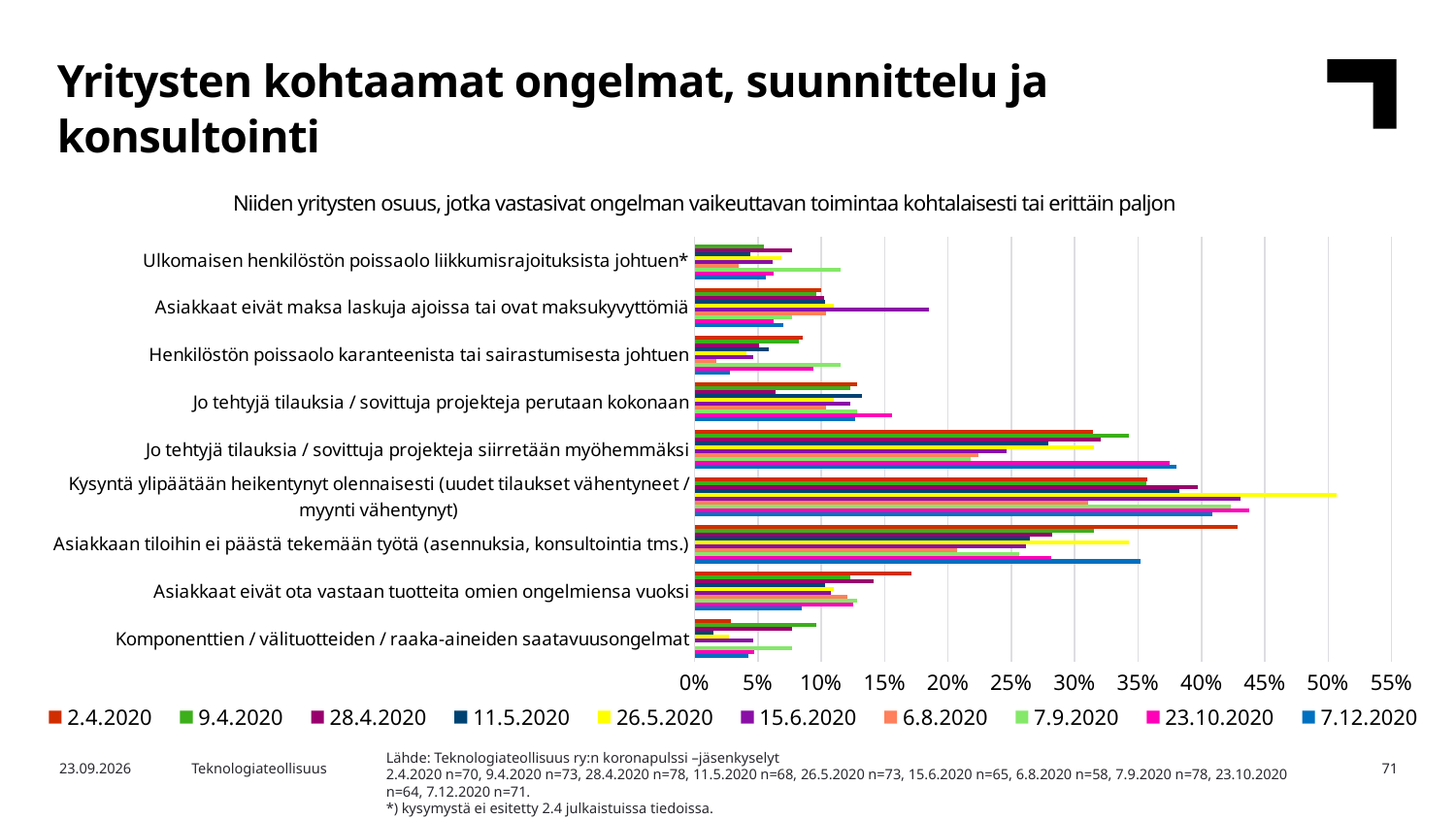
What is the highest value shown on the horizontal axis of the chart? 55% How many series (survey dates) does the legend list? 10 What kind of chart is shown on the slide? Bar chart How many problem categories are listed on the vertical axis of the chart? 9 Which category has the longest bars overall in the chart? Kysyntä ylipäätään heikentynyt olennaisesti (uudet tilaukset vähentyneet / myynti vähentynyt) Which series has the longest bar for 'Kysyntä ylipäätään heikentynyt olennaisesti'? 26.5.2020 Is the 26.5.2020 value for 'Kysyntä ylipäätään heikentynyt olennaisesti' greater or less than 45%? greater Is the 2.4.2020 value for 'Komponenttien / välituotteiden / raaka-aineiden saatavuusongelmat' greater or less than 5%? less Is the 2.4.2020 value for 'Asiakkaat eivät ota vastaan tuotteita omien ongelmiensa vuoksi' greater or less than 15%? greater What is the first series listed in the chart legend? 2.4.2020 For the 2.4.2020 series, which is larger: 'Jo tehtyjä tilauksia / sovittuja projekteja siirretään myöhemmäksi' or 'Asiakkaat eivät maksa laskuja ajoissa tai ovat maksukyvyttömiä'? Jo tehtyjä tilauksia / sovittuja projekteja siirretään myöhemmäksi